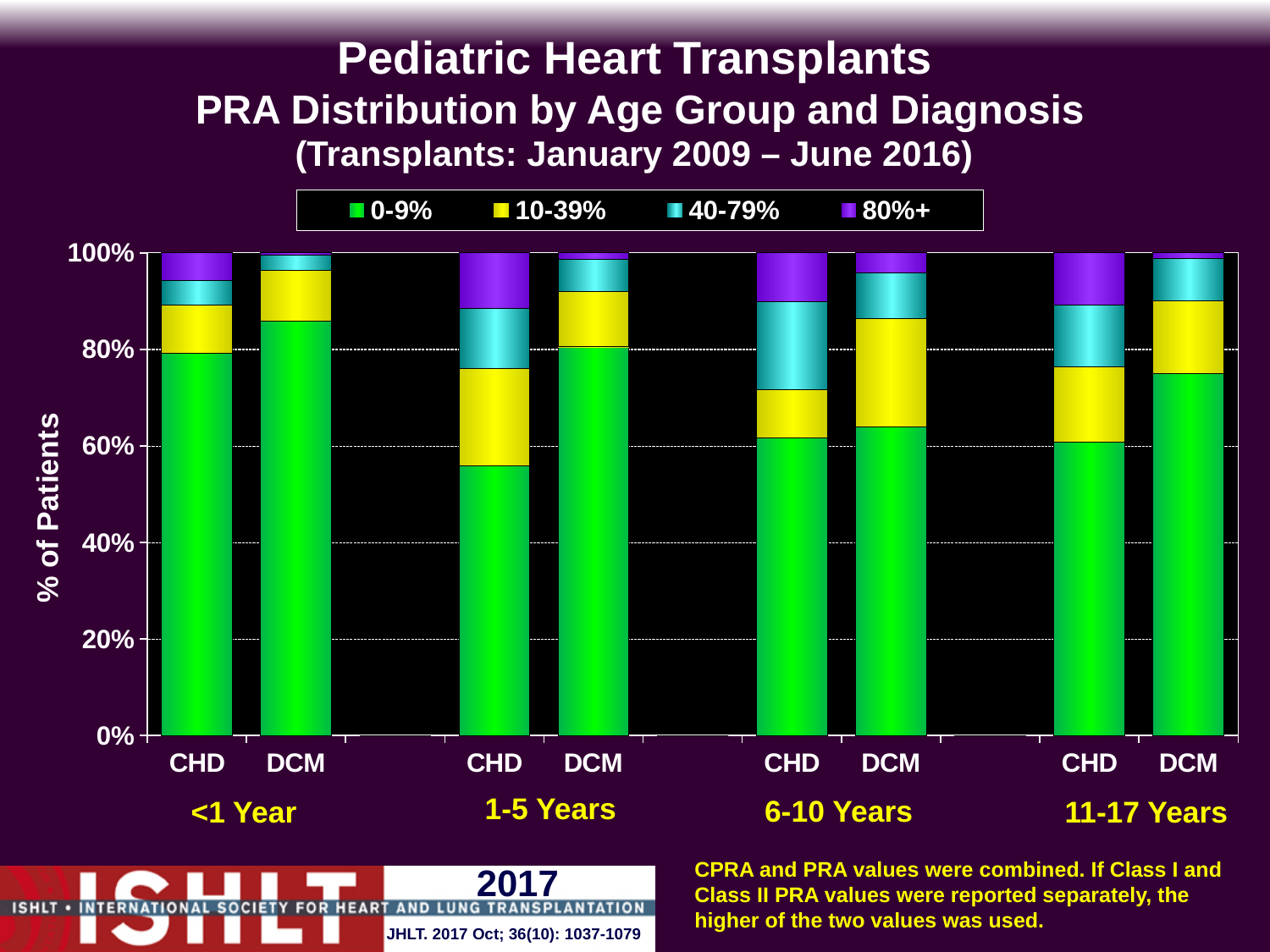
What kind of chart is shown on the slide? Stacked bar chart Is the 0-9% share for DCM in the <1 Year group greater or less than 80%? greater How many bars are plotted in the chart? 8 Is the 0-9% share for CHD in the 6-10 Years group greater or less than 80%? less In the 1-5 Years group, which diagnosis has the larger 0-9% share, CHD or DCM? DCM What is the label on the y axis? % of Patients Which bar has the largest 0-9% segment? DCM, <1 Year How many series does the legend list? 4 Is the 0-9% share for CHD in the 1-5 Years group greater or less than 60%? less Which bar has the smallest 0-9% segment? CHD, 1-5 Years How many age groups are shown along the x axis? 4